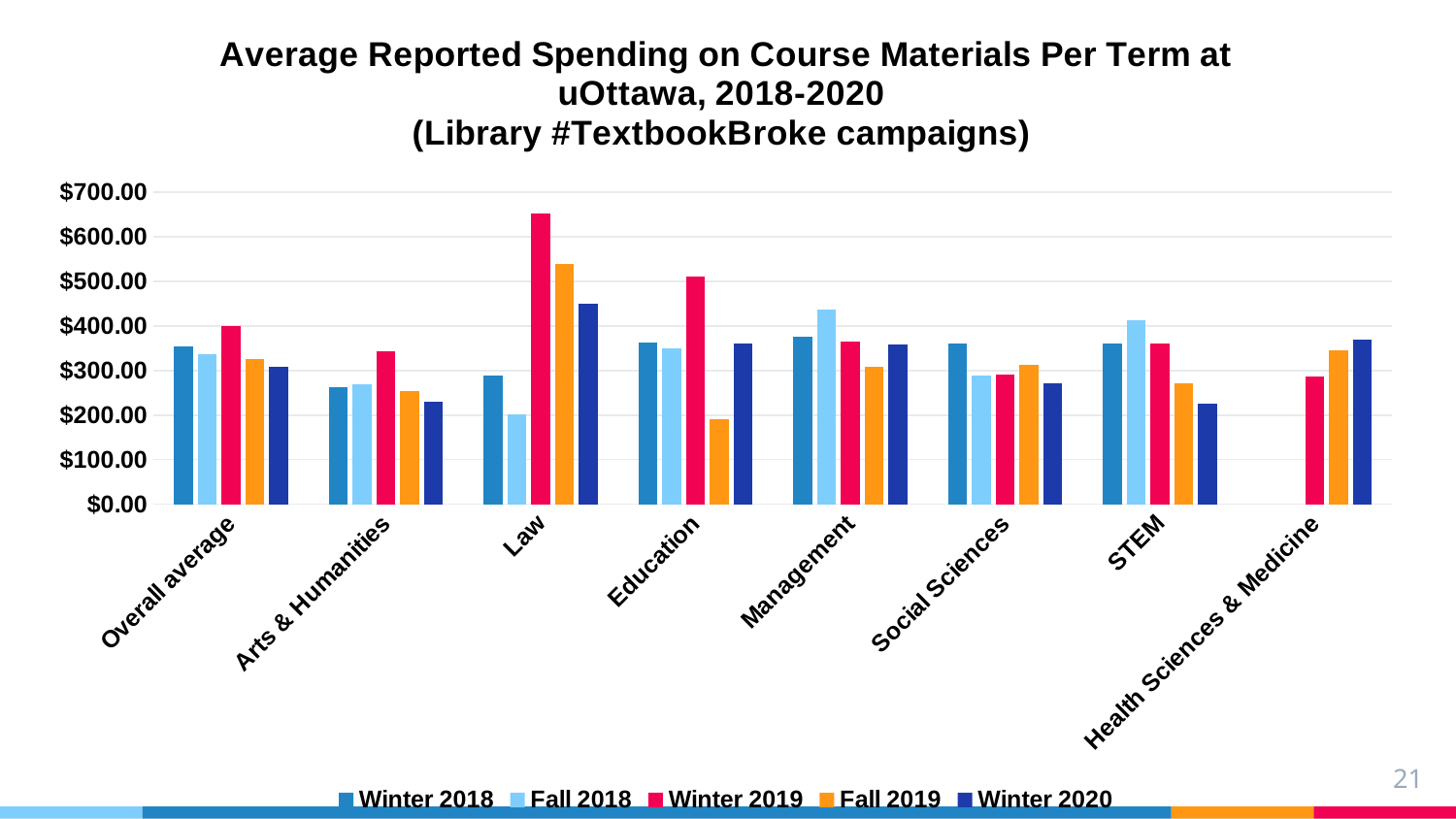
Is the Winter 2019 value for Education greater or less than $500.00? greater Is the Fall 2018 value for Management greater or less than $400.00? greater Which series has the highest value for Law? Winter 2019 How many series does the legend list? 5 Which series has the lowest value for Education? Fall 2019 For Law, which is larger: the Winter 2019 value or the Fall 2018 value? Winter 2019 Is the Winter 2019 value for Law greater or less than $600.00? greater What kind of chart is shown on the slide? bar chart Which category has the highest bar in the chart? Law Which category has bars for only three of the five series? Health Sciences & Medicine How many categories are shown on the x axis? 8